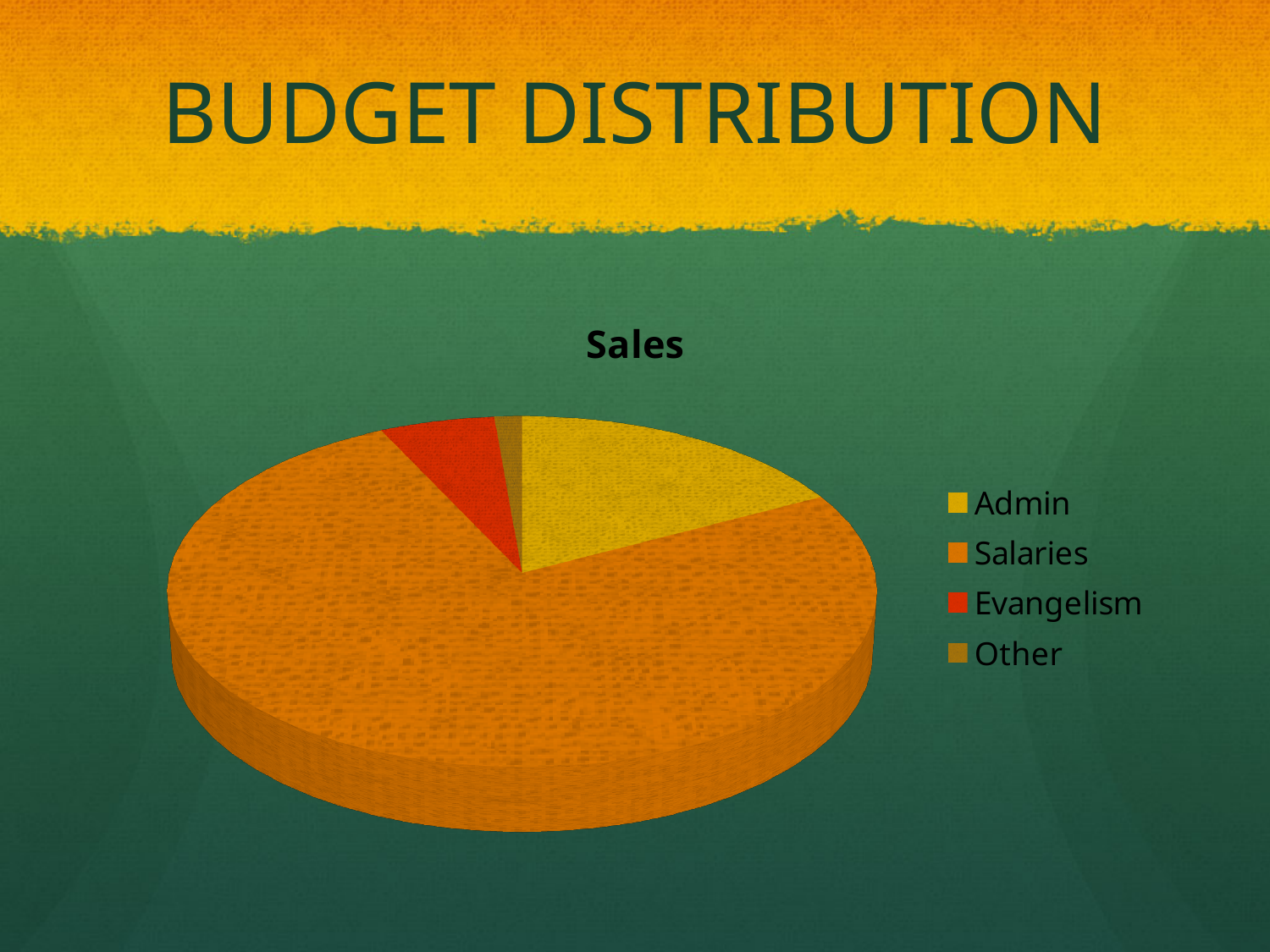
Which slice is larger, Salaries or Admin? Salaries Which category has the largest slice of the pie? Salaries What is the title of the chart? Sales What kind of chart is shown on the slide? Pie chart Which slice is larger, Evangelism or Other? Evangelism How many entries does the legend list? 4 Which category is listed first in the legend? Admin Which category has the smallest slice of the pie? Other Which category is shown in red on the pie chart? Evangelism Which slice is larger, Admin or Evangelism? Admin How many categories does the pie chart have? 4